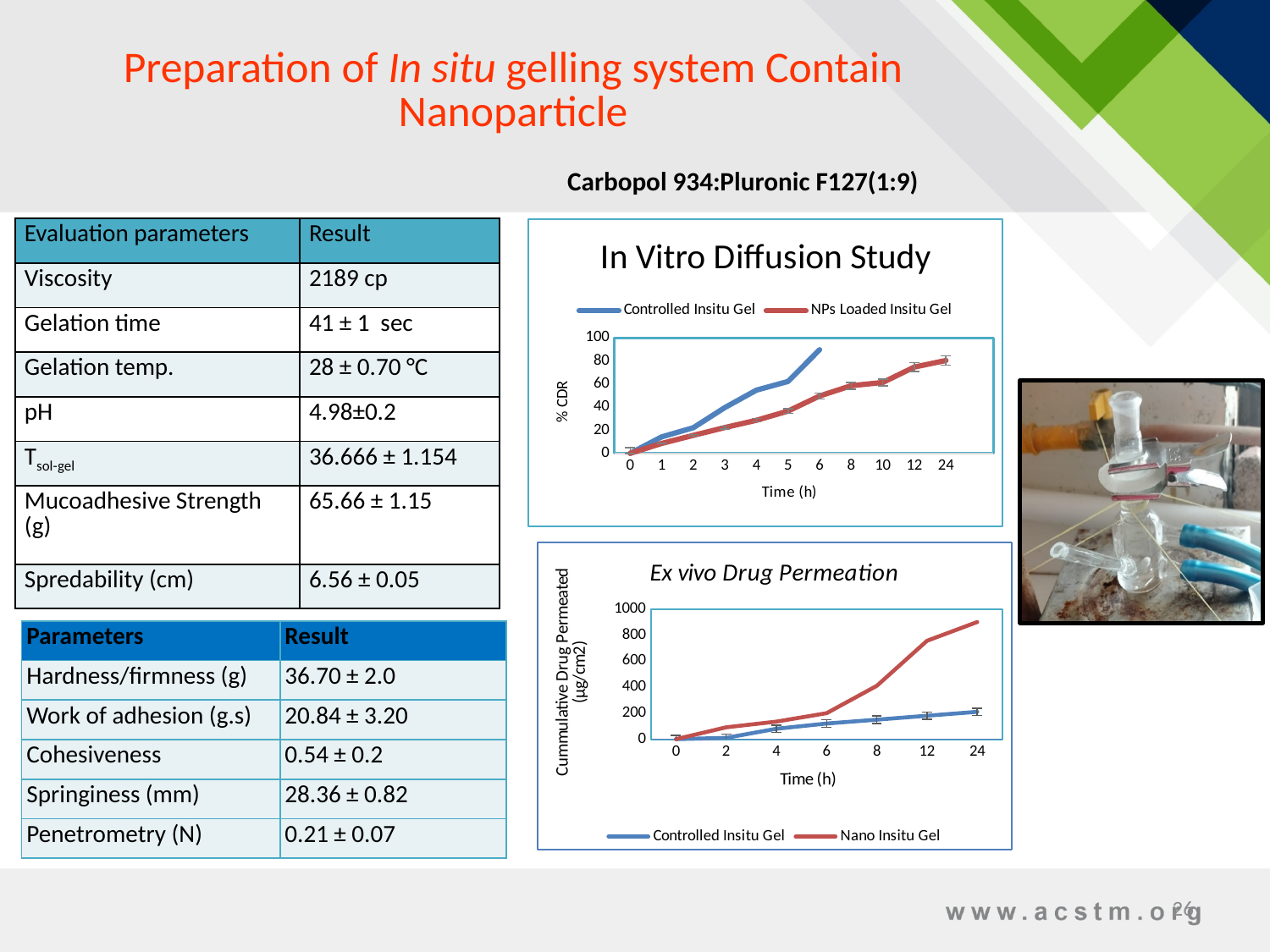
In the "Ex vivo Drug Permeation" chart, which series has the higher value at 24 h, Controlled Insitu Gel or Nano Insitu Gel? Nano Insitu Gel What is the y-axis label of the "In Vitro Diffusion Study" chart? % CDR In the "In Vitro Diffusion Study" chart, does the % CDR for NPs Loaded Insitu Gel rise or fall as time increases? rise How many time points are shown on the x axis of the "In Vitro Diffusion Study" chart? 11 What type of chart is the "In Vitro Diffusion Study" chart? line chart In the "In Vitro Diffusion Study" chart, is the % CDR for Controlled Insitu Gel at 6 h greater or less than 80? greater How many time points are shown on the x axis of the "Ex vivo Drug Permeation" chart? 7 How many series does the legend of the "In Vitro Diffusion Study" chart list? 2 In the "In Vitro Diffusion Study" chart, is the % CDR for NPs Loaded Insitu Gel at 12 h greater or less than 60? greater In the "Ex vivo Drug Permeation" chart, is the value for Nano Insitu Gel at 24 h greater or less than 800? greater How many series does the legend of the "Ex vivo Drug Permeation" chart list? 2 In the "In Vitro Diffusion Study" chart, which series has the higher % CDR at 6 h, Controlled Insitu Gel or NPs Loaded Insitu Gel? Controlled Insitu Gel